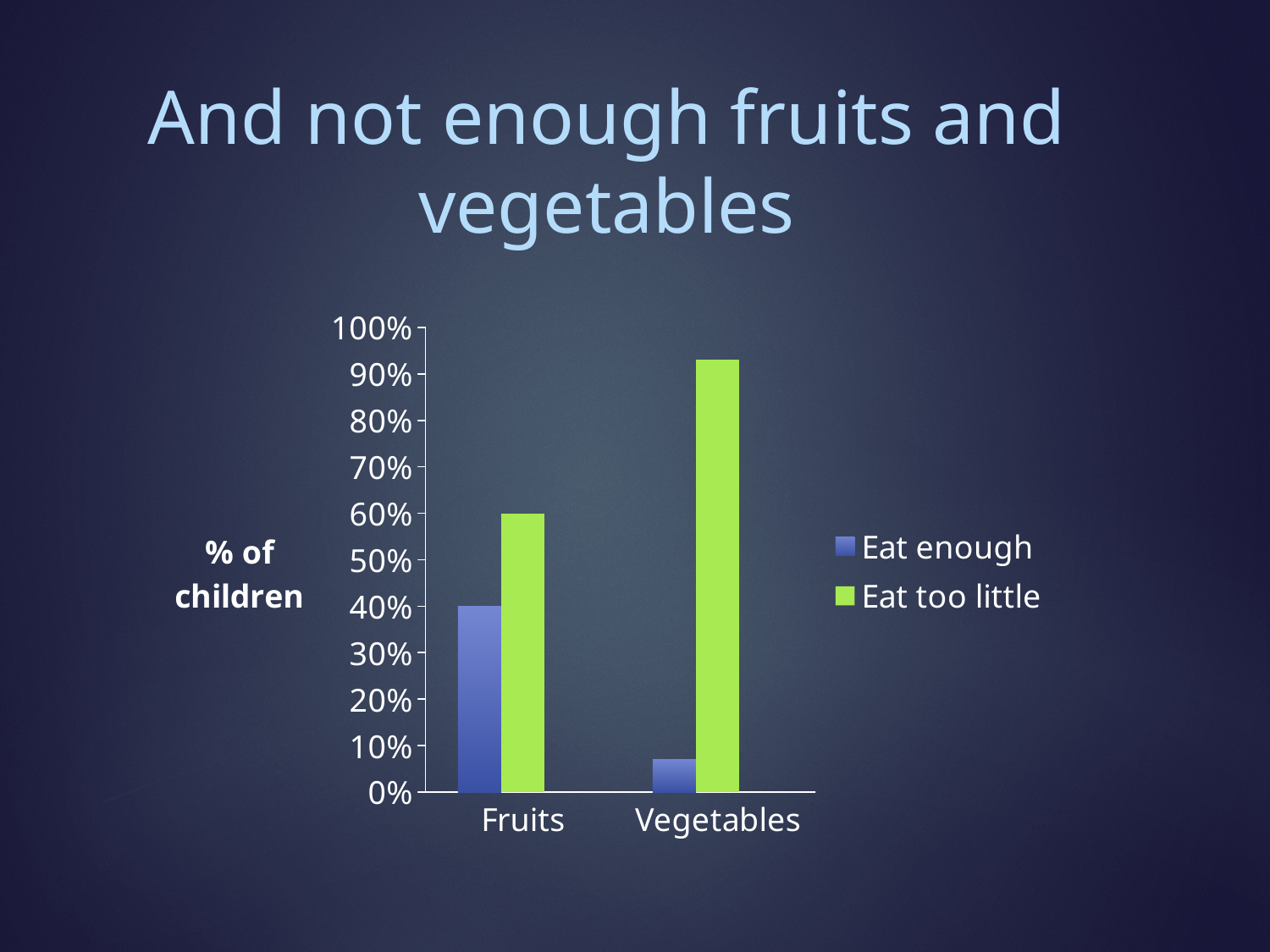
What is the label on the vertical axis of the chart? % of children How many series does the chart's legend list? 2 Which category has the lowest value for Eat enough? Vegetables What is the value for Eat too little in the Fruits category? 60% What are the two series listed in the chart's legend? Eat enough, Eat too little What is the value for Eat enough in the Fruits category? 40% What kind of chart is shown on the slide? bar chart Is the value for Eat enough in the Vegetables category greater or less than 10%? less Is the value for Eat too little in the Vegetables category greater or less than 90%? greater In the Fruits category, which is larger: Eat enough or Eat too little? Eat too little How many categories are shown on the x axis of the chart? 2 Which category has the highest value for Eat too little? Vegetables